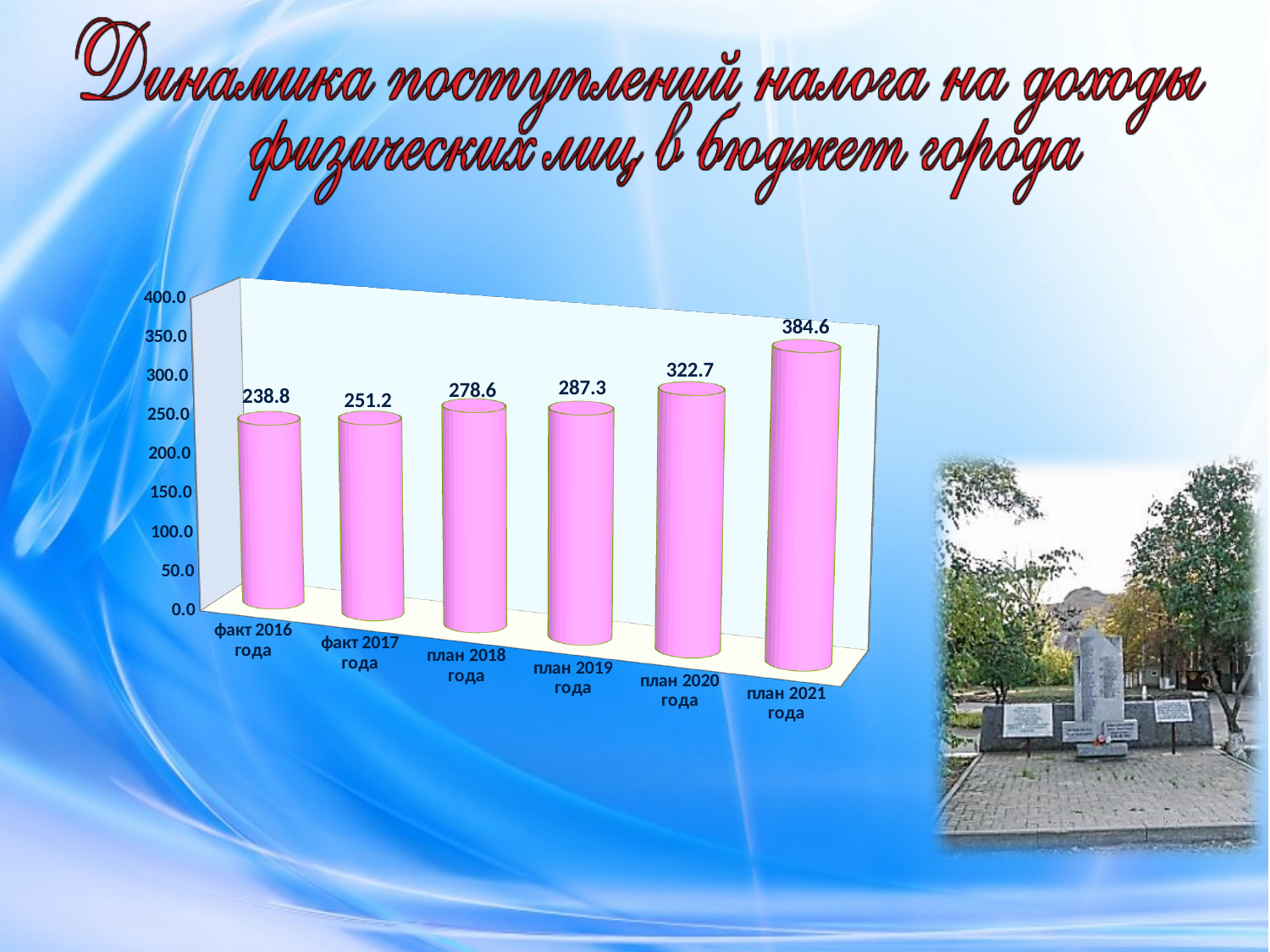
How many categories are shown on the x axis? 6 Which category has the highest value? план 2021 года What is the value for план 2018 года? 278.6 Do the values rise or fall from факт 2016 года to план 2021 года? rise What is the value for факт 2016 года? 238.8 What kind of chart is shown on the slide? bar chart What is the difference between the values for план 2021 года and план 2020 года? 61.9 Which is larger, the value for план 2019 года or the value for план 2018 года? план 2019 года Which category has the lowest value? факт 2016 года Is the value for план 2021 года greater or less than 350.0? greater What is the value for план 2020 года? 322.7 What is the difference between the values for факт 2017 года and факт 2016 года? 12.4